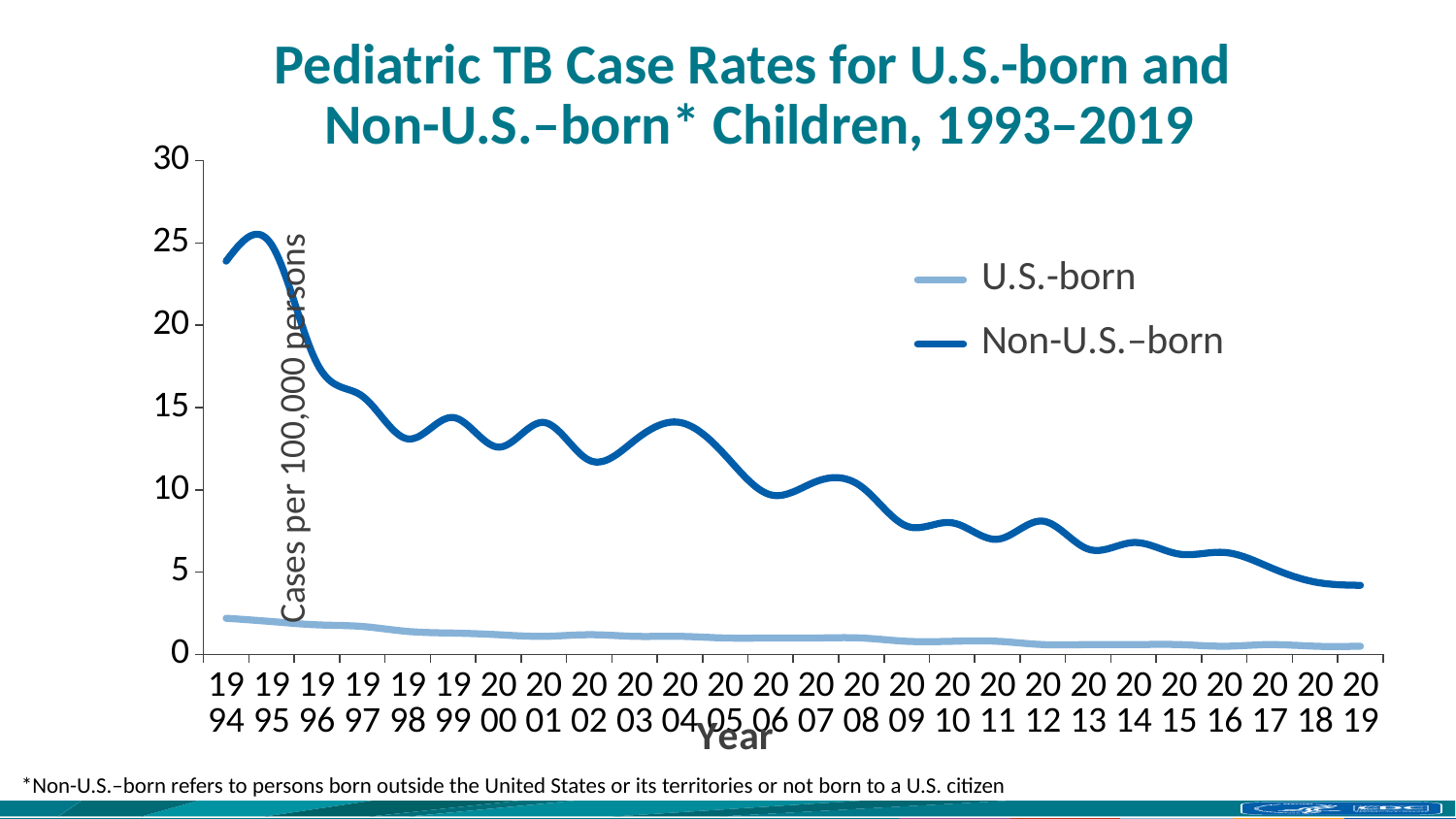
Does the U.S.-born case rate rise or fall overall from 1994 to 2019? fall Which two series are listed in the legend? U.S.-born and Non-U.S.–born How many year labels are shown along the x axis? 26 Is the U.S.-born value for 1994 greater or less than 5? less What is the label of the y axis? Cases per 100,000 persons How many series does the legend list? 2 Is the Non-U.S.–born value for 2004 greater or less than 10? greater What kind of chart is shown on the slide? line chart Does the Non-U.S.–born case rate rise or fall overall from 1994 to 2019? fall Is the Non-U.S.–born value for 2019 greater or less than 5? less Which series has the higher case rate in 2010, U.S.-born or Non-U.S.–born? Non-U.S.–born